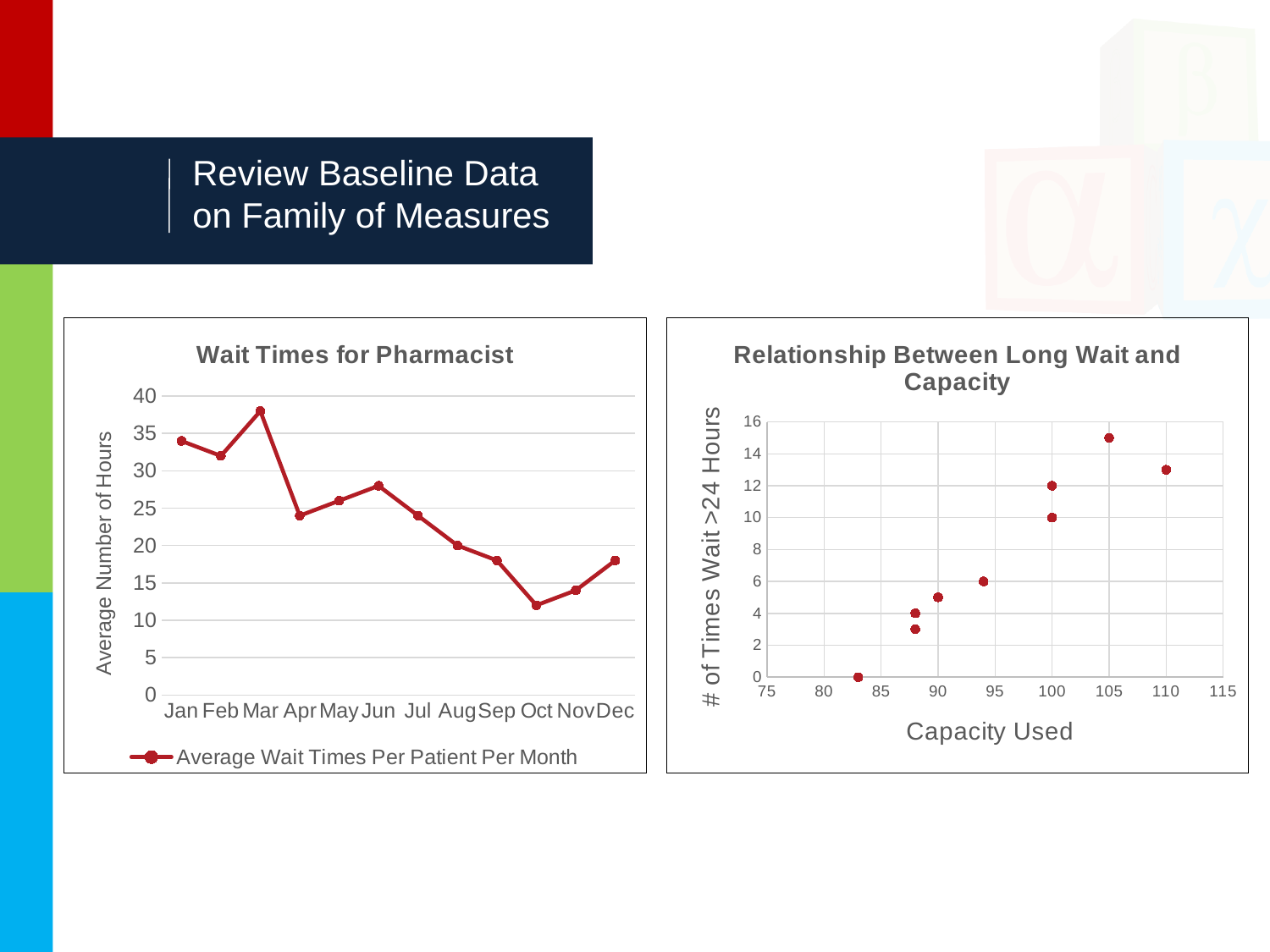
In the 'Wait Times for Pharmacist' chart, is the value for Oct greater or less than 15? less What kind of chart is the 'Relationship Between Long Wait and Capacity' chart? scatter chart How many series does the legend of the 'Wait Times for Pharmacist' chart list? 1 How many data points are plotted in the 'Relationship Between Long Wait and Capacity' chart? 9 What kind of chart is the 'Wait Times for Pharmacist' chart? line chart In the 'Wait Times for Pharmacist' chart, which month has the lowest average wait time? Oct In the 'Wait Times for Pharmacist' chart, do the values generally rise or fall from Jan to Dec? fall In the 'Wait Times for Pharmacist' chart, is the value for Mar greater or less than 35? greater In the 'Wait Times for Pharmacist' chart, which is larger, the value for Jan or the value for Dec? Jan What is the x-axis title of the 'Relationship Between Long Wait and Capacity' chart? Capacity Used In the 'Wait Times for Pharmacist' chart, which month has the highest average wait time? Mar How many months are plotted on the x axis of the 'Wait Times for Pharmacist' chart? 12